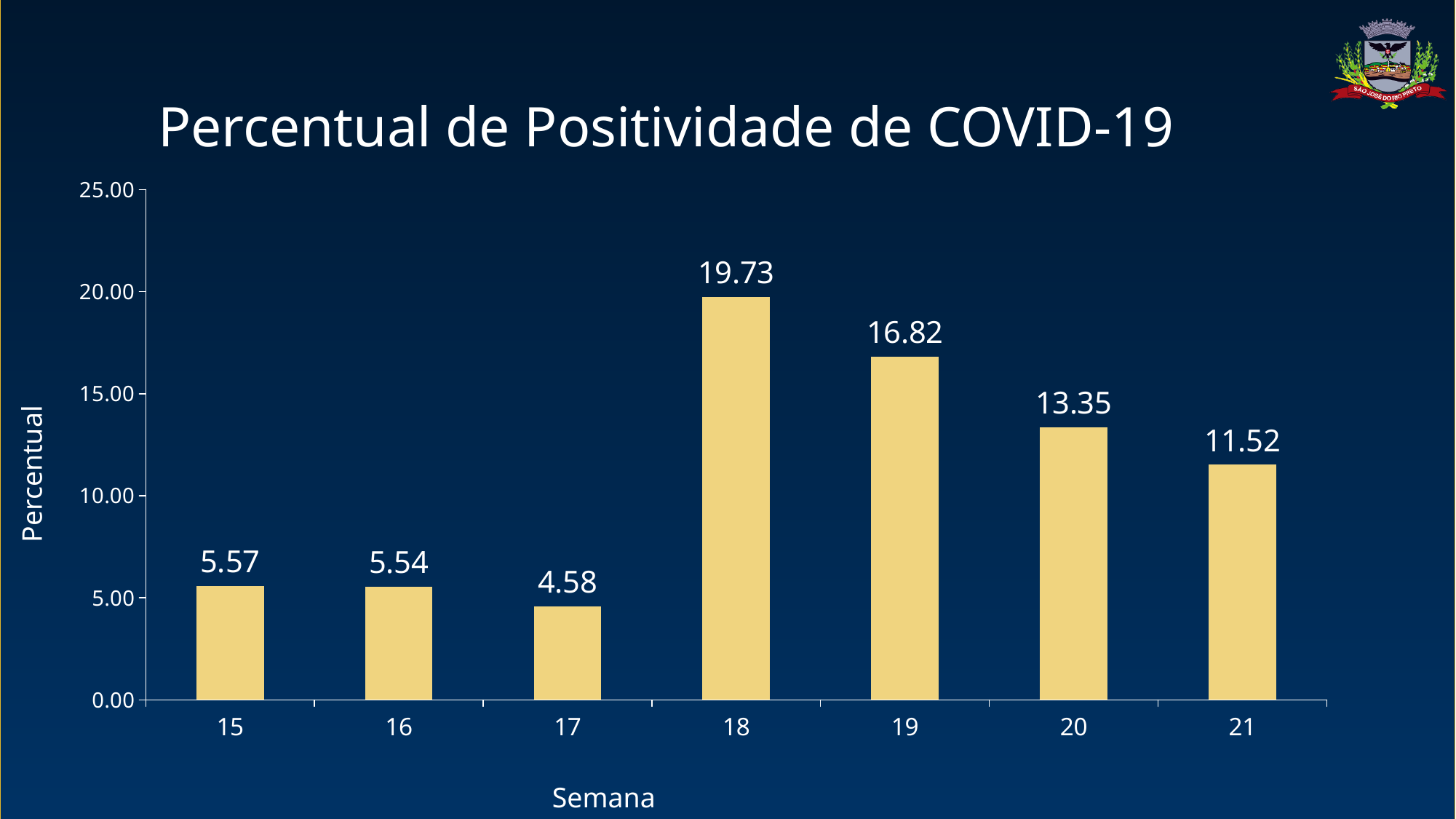
What is the difference between the values for week 18 and week 19? 2.91 Which week has the highest value? 18 What is the value for week 18? 19.73 What is the value for week 21? 11.52 What is the title of the chart? Percentual de Positividade de COVID-19 How many weeks are shown on the x axis? 7 Which is larger, the value for week 19 or the value for week 20? 19 Is the value for week 18 greater or less than 15.00? greater What is the value for week 16? 5.54 Which week has the lowest value? 17 What kind of chart is shown on the slide? bar chart What is the difference between the values for week 20 and week 21? 1.83